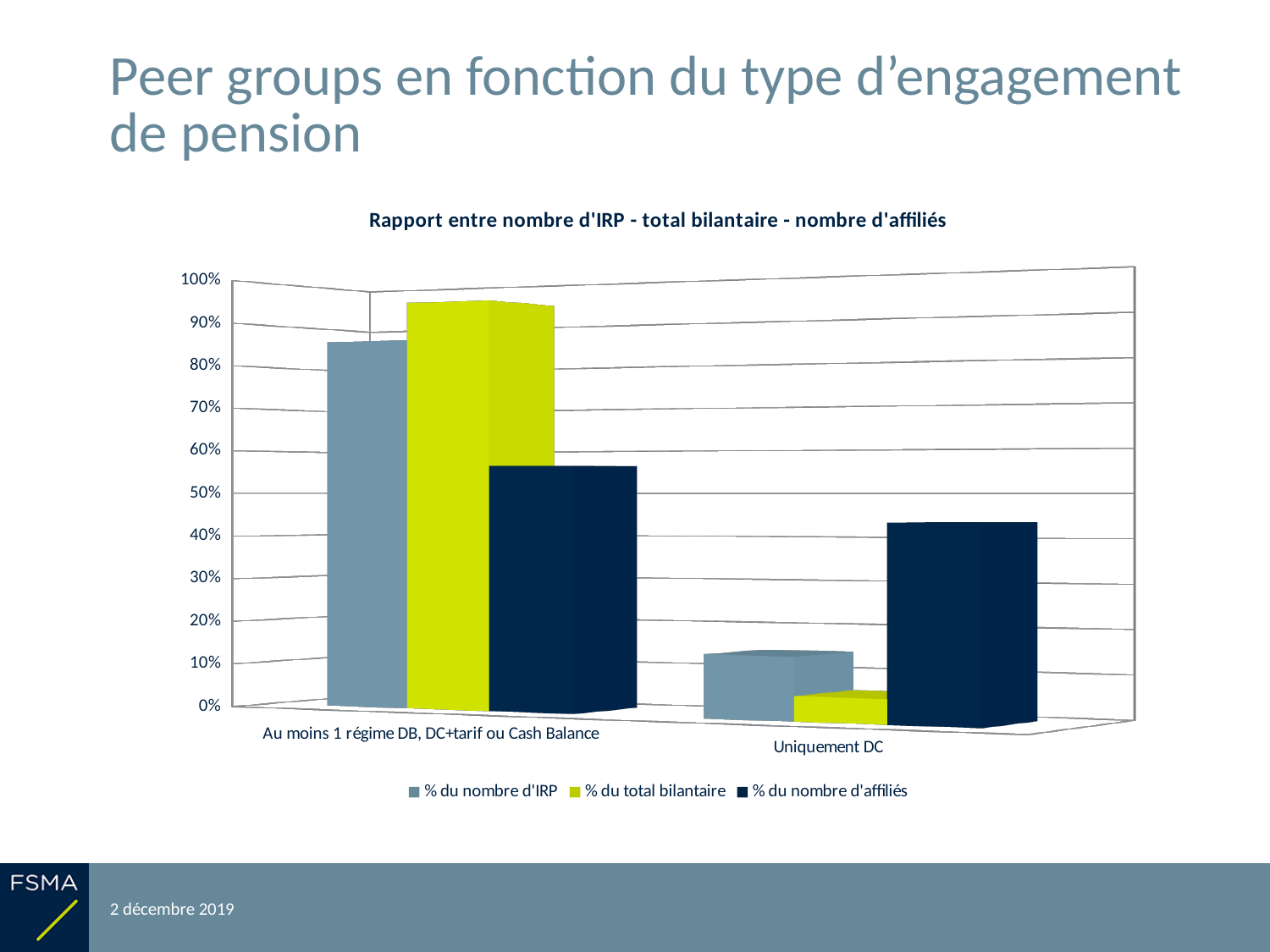
For the category 'Au moins 1 régime DB, DC+tarif ou Cash Balance', which series has the highest value? % du total bilantaire Is the value of '% du total bilantaire' for 'Uniquement DC' greater or less than 10%? less Which series is shown in yellow-green in the chart? % du total bilantaire Which is larger: '% du nombre d'IRP' for 'Au moins 1 régime DB, DC+tarif ou Cash Balance' or '% du nombre d'IRP' for 'Uniquement DC'? Au moins 1 régime DB, DC+tarif ou Cash Balance For the category 'Uniquement DC', which series has the highest value? % du nombre d'affiliés How many categories are shown on the x axis of the chart? 2 How many series does the chart legend list? 3 Is the value of '% du nombre d'IRP' for 'Au moins 1 régime DB, DC+tarif ou Cash Balance' greater or less than 70%? greater For the category 'Uniquement DC', which series has the lowest value? % du total bilantaire Is the value of '% du nombre d'affiliés' for 'Uniquement DC' greater or less than 30%? greater What is the title of the chart? Rapport entre nombre d'IRP - total bilantaire - nombre d'affiliés What kind of chart is shown on the slide? bar chart